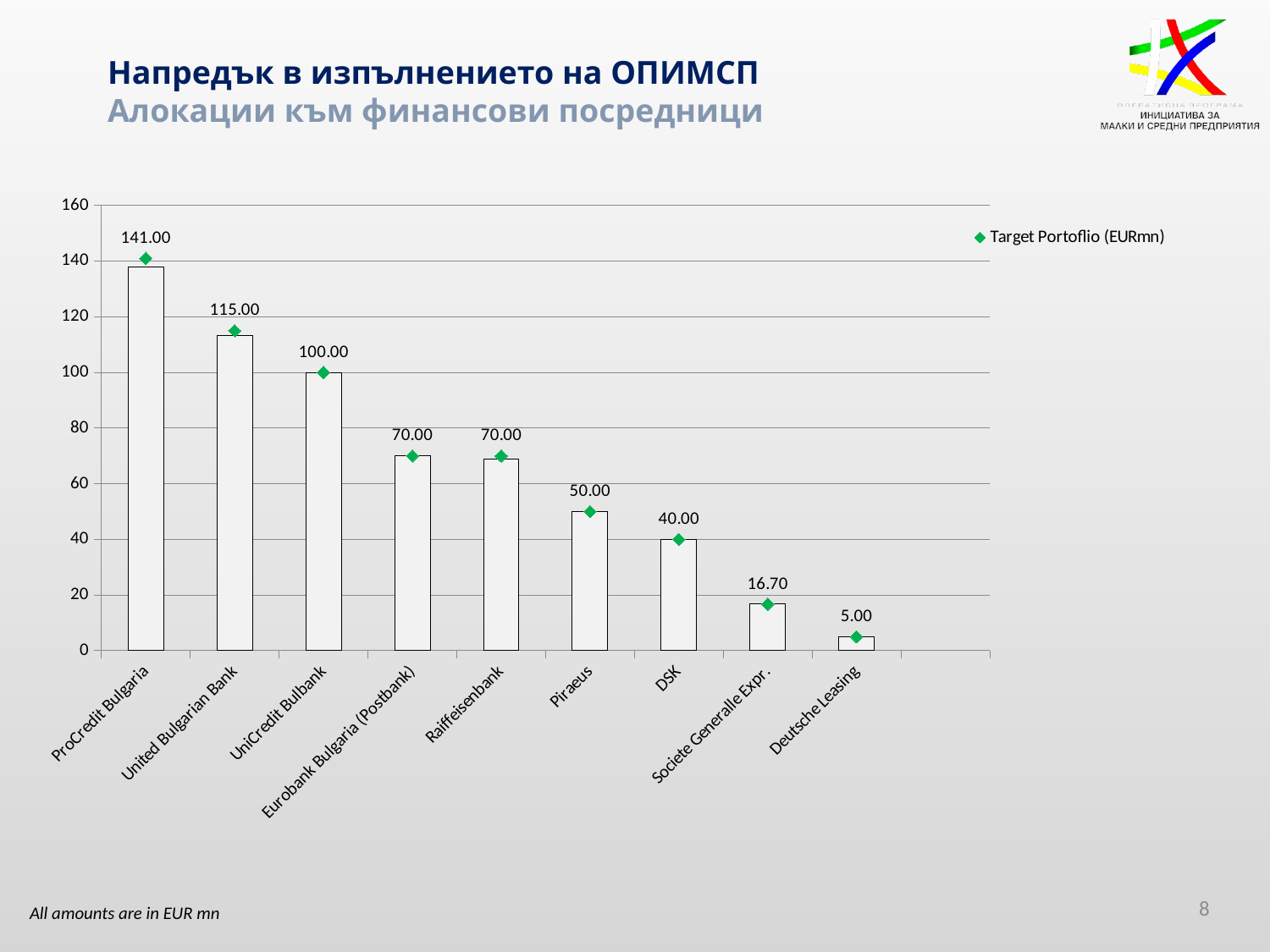
What is the Target Portoflio (EURmn) value for United Bulgarian Bank? 115.00 What is the Target Portoflio (EURmn) value for ProCredit Bulgaria? 141.00 What is the difference between the Target Portoflio (EURmn) values for ProCredit Bulgaria and UniCredit Bulbank? 41.00 Which financial intermediary has the highest Target Portoflio (EURmn) value? ProCredit Bulgaria Do the Target Portoflio (EURmn) values rise or fall from left to right along the x axis? fall How many series does the chart legend list? 1 Which financial intermediary has the lowest Target Portoflio (EURmn) value? Deutsche Leasing How many financial intermediaries are shown on the x axis of the chart? 9 What is the legend entry shown on the chart? Target Portoflio (EURmn) What is the Target Portoflio (EURmn) value for DSK? 40.00 What is the Target Portoflio (EURmn) value for Societe Generalle Expr.? 16.70 Which has a larger Target Portoflio (EURmn) value, Piraeus or DSK? Piraeus